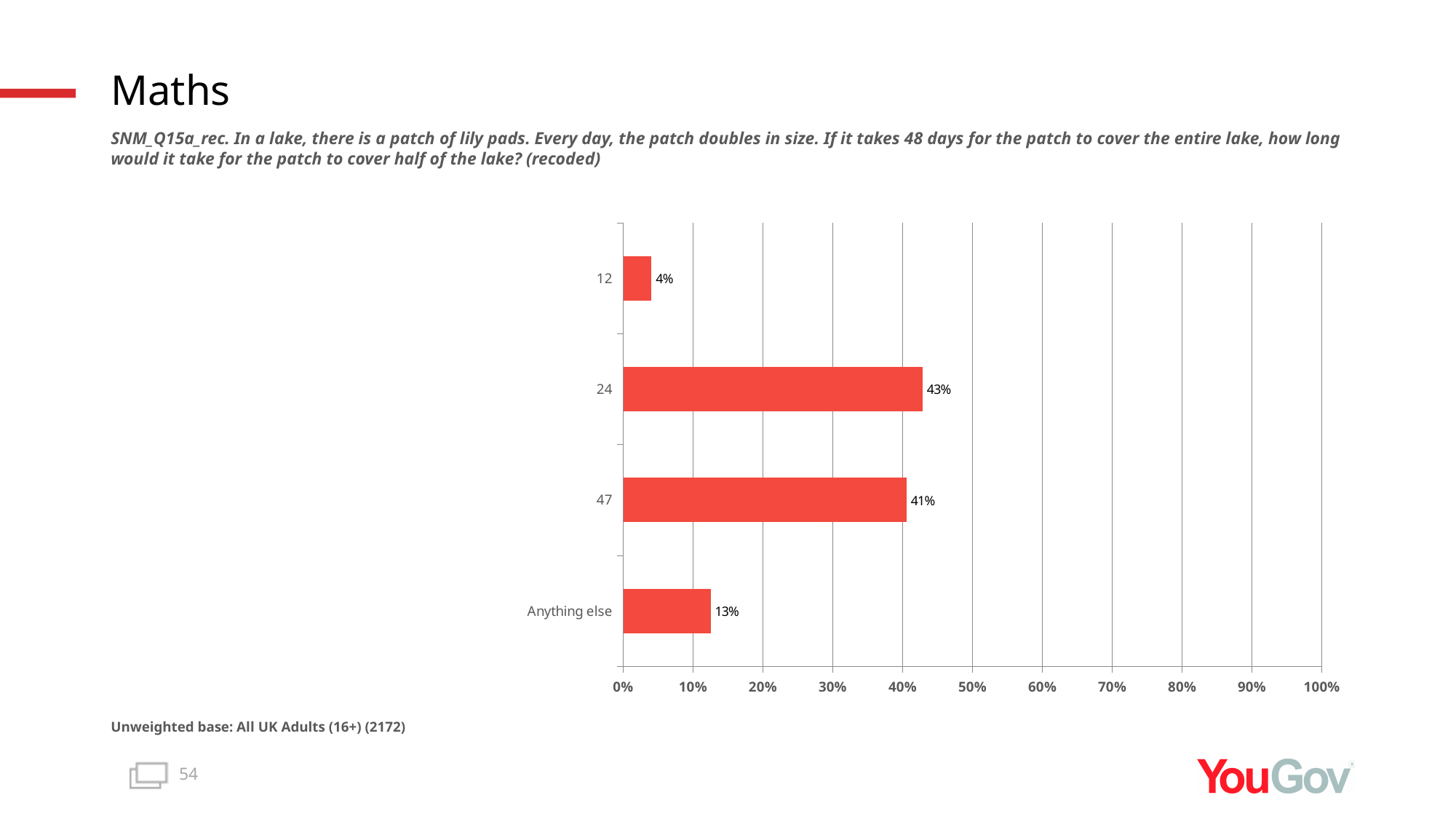
What percentage of respondents answered "47"? 41% What kind of chart is shown on the slide? bar chart What is the difference in percentage points between the "Anything else" and "12" categories? 9 Is the value for "47" greater or less than 50%? less Which answer category has the highest percentage? 24 What percentage of respondents answered "24"? 43% What percentage of respondents answered "12"? 4% What percentage of respondents answered "Anything else"? 13% Which has a larger value, "Anything else" or "12"? Anything else Which answer category has the lowest percentage? 12 What is the difference in percentage points between the "24" and "47" categories? 2 How many answer categories are shown in the chart? 4